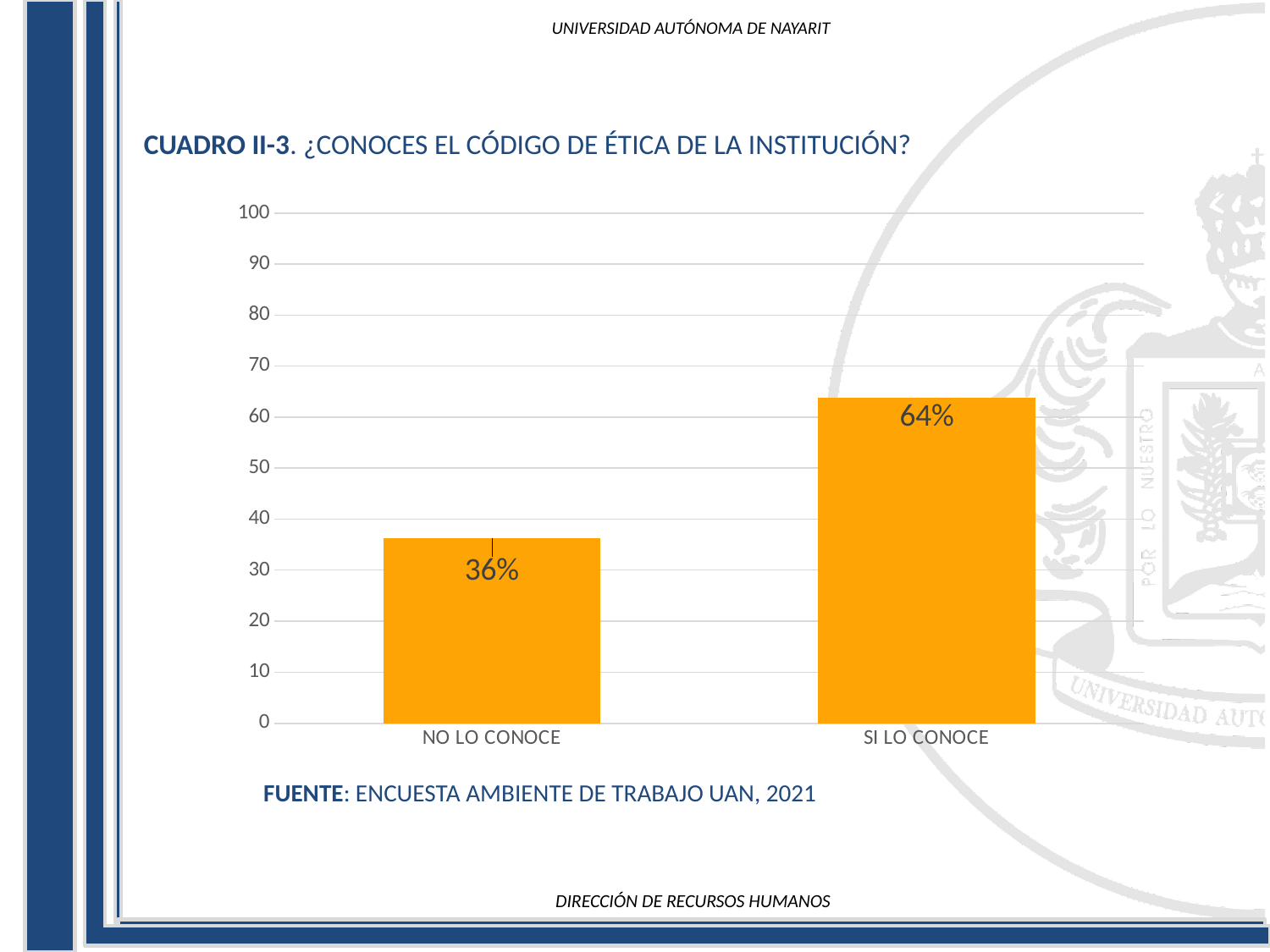
Which category has the highest value? SI LO CONOCE Which category has the lowest value? NO LO CONOCE How many categories are shown on the x axis? 2 What kind of chart is shown on the slide? bar chart What is the difference between the values for SI LO CONOCE and NO LO CONOCE? 28% What is the source cited below the chart? ENCUESTA AMBIENTE DE TRABAJO UAN, 2021 What is the title of the chart (CUADRO II-3)? ¿CONOCES EL CÓDIGO DE ÉTICA DE LA INSTITUCIÓN? What is the value for SI LO CONOCE? 64% Which is larger, the value for NO LO CONOCE or the value for SI LO CONOCE? SI LO CONOCE What is the value for NO LO CONOCE? 36% Is the value for SI LO CONOCE greater or less than 50? greater Is the value for NO LO CONOCE greater or less than 40? less